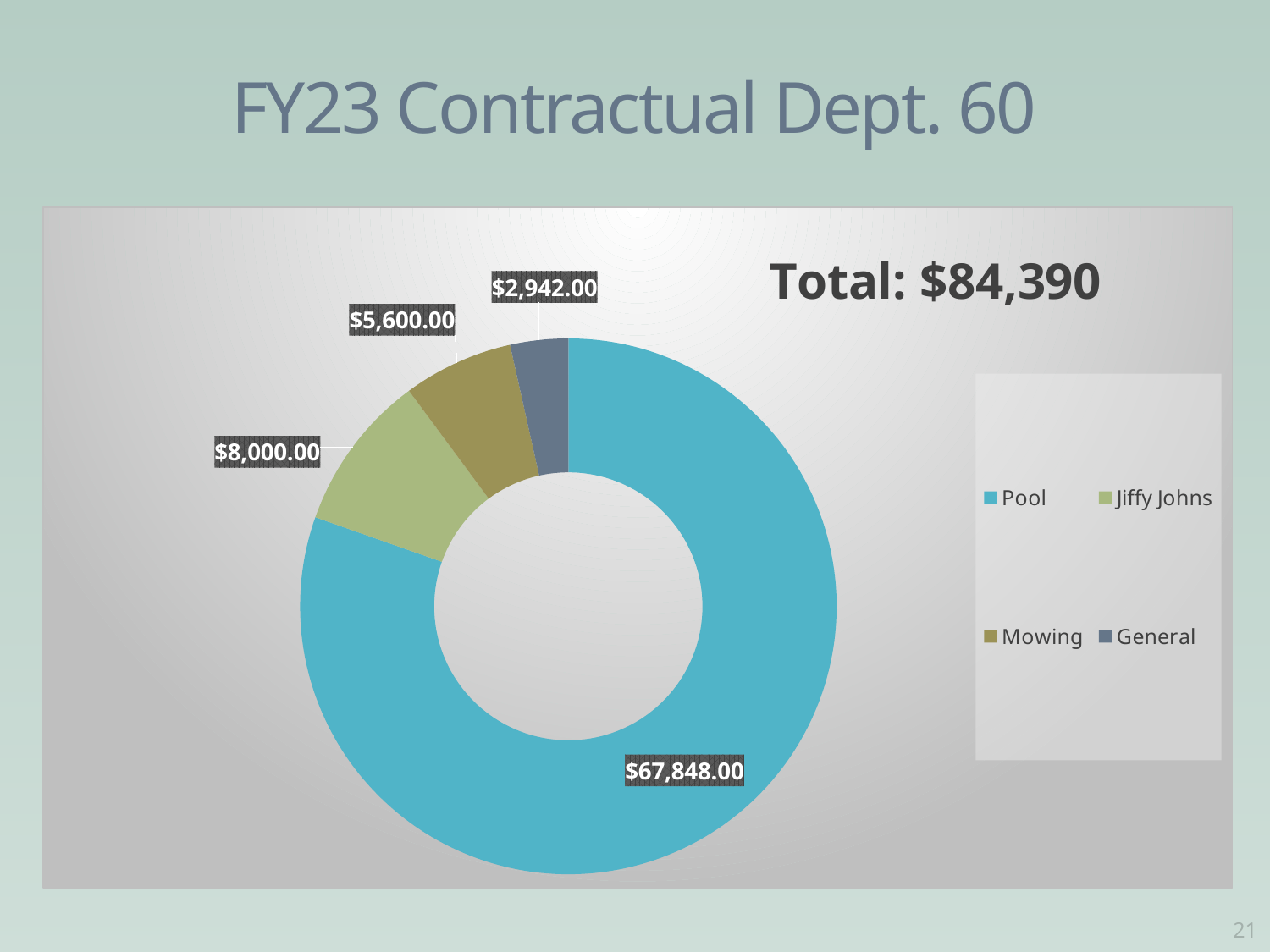
Which category has the largest value? Pool What is the value for Mowing? $5,600.00 What is the title of the slide? FY23 Contractual Dept. 60 Which category has the smallest value? General What kind of chart is shown on the slide? Doughnut chart What is the value for Jiffy Johns? $8,000.00 What is the difference between the values for Jiffy Johns and Mowing? $2,400.00 What is the value for General? $2,942.00 What is the value for Pool? $67,848.00 What total is stated on the chart? $84,390 How many categories are shown in the chart? 4 Which is larger, the value for Mowing or the value for General? Mowing